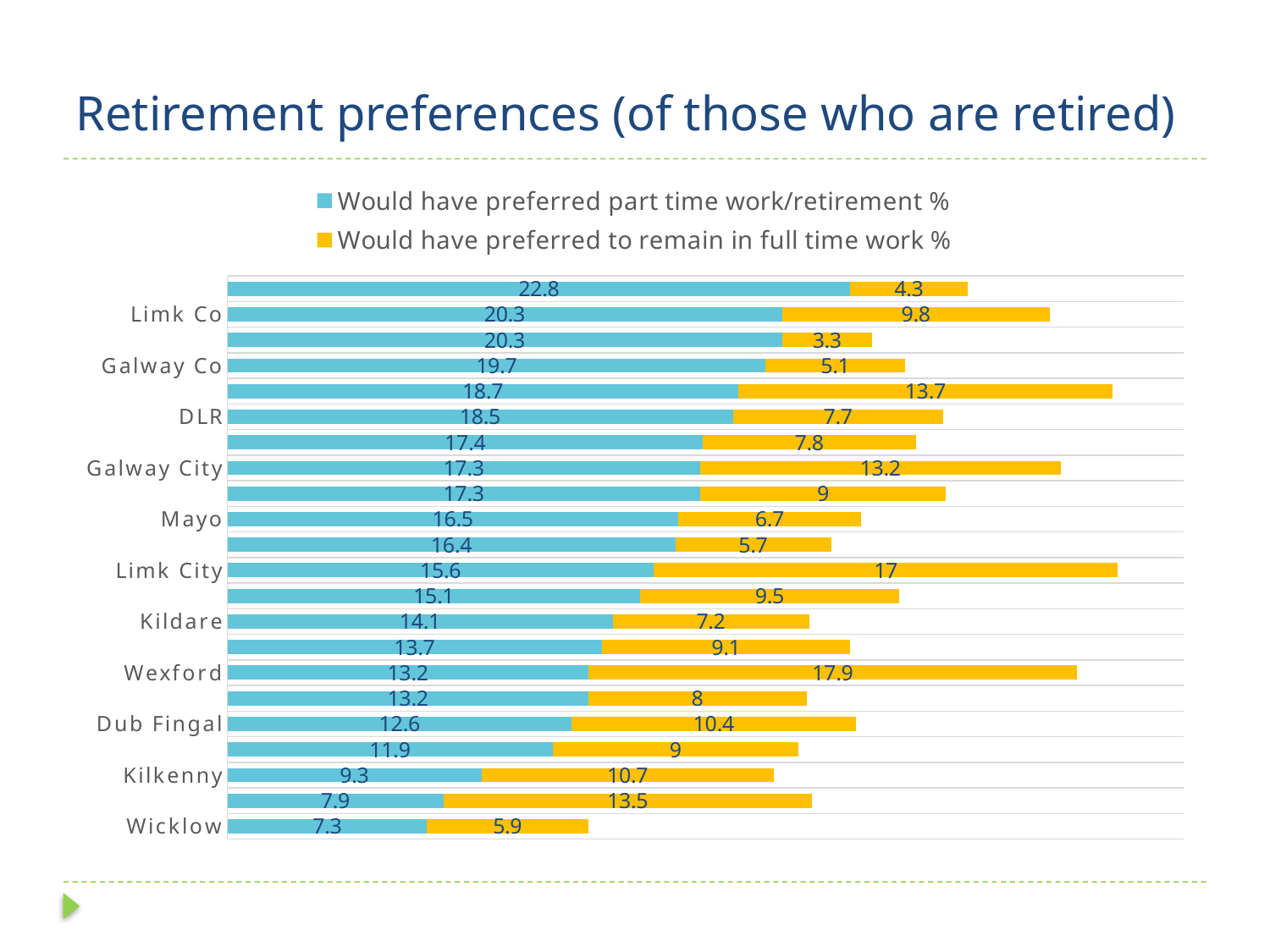
What is the 'Would have preferred to remain in full time work %' value for Limk City? 17 How many series does the legend list? 2 What is the title of the slide? Retirement preferences (of those who are retired) What kind of chart is shown on the slide? Stacked bar chart Which category has the lowest 'Would have preferred part time work/retirement %' value? Wicklow What is the 'Would have preferred to remain in full time work %' value for Galway City? 13.2 What is the total of the stacked bar for Kilkenny? 20 What is the 'Would have preferred part time work/retirement %' value for Wicklow? 7.3 For Limk Co, what is the difference between the part time work/retirement value and the full time work value? 10.5 Which has the larger 'Would have preferred part time work/retirement %' value, Mayo or Kildare? Mayo What is the total of the stacked bar for Wexford? 31.1 Which category has the highest 'Would have preferred to remain in full time work %' value? Wexford